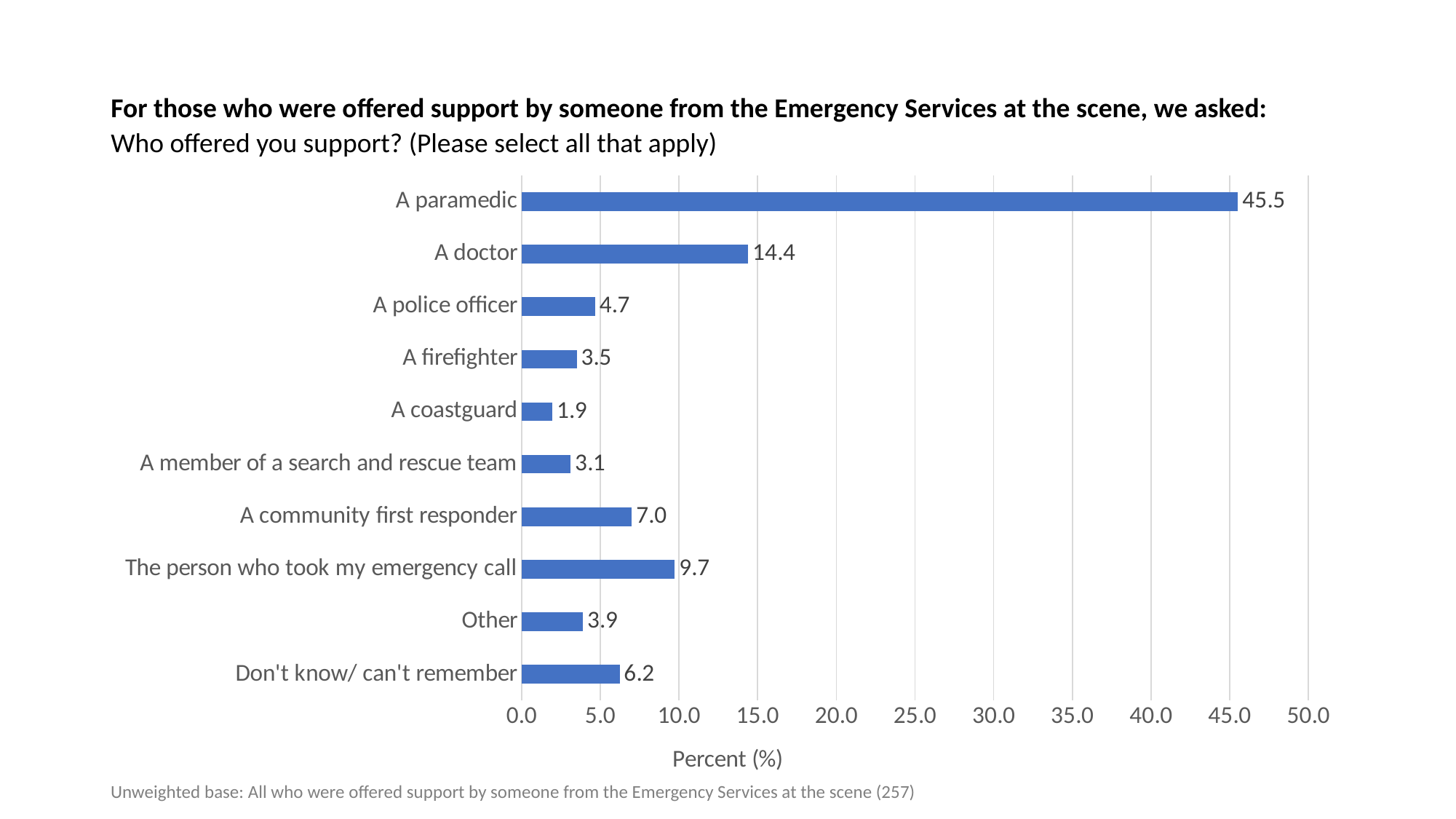
What is the unweighted base size stated below the chart? 257 Which category has the highest value? A paramedic What is the difference between the values for 'A paramedic' and 'A doctor'? 31.1 What is the value for 'A paramedic'? 45.5 Which is larger, the value for 'A police officer' or the value for 'Other'? A police officer What is the value for 'A community first responder'? 7.0 Is the value for 'A doctor' greater or less than 10.0? greater What is the label of the horizontal axis? Percent (%) What kind of chart is shown on the slide? Bar chart How many categories are shown in the chart? 10 Which category has the lowest value? A coastguard What is the value for 'The person who took my emergency call'? 9.7